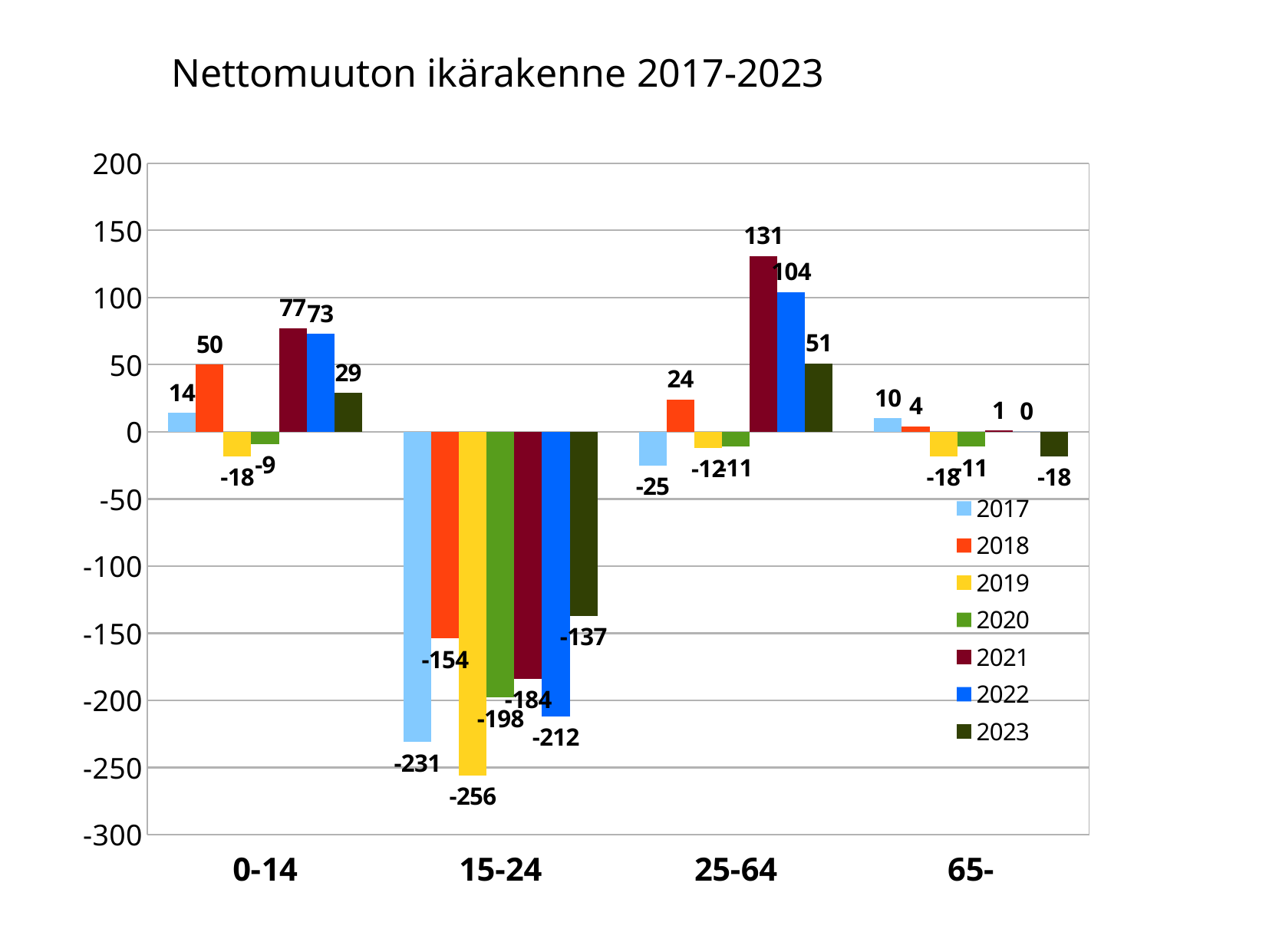
What is the value for 2019 in the 15-24 age group? -256 How many age groups are shown on the x axis? 4 What type of chart is shown on the slide? Bar chart How many series does the legend list? 7 What is the value for 2023 in the 15-24 age group? -137 What is the difference between the 2018 and 2023 values in the 0-14 age group? 21 What is the value for 2021 in the 25-64 age group? 131 Which year has the highest value in the 0-14 age group? 2021 What is the value for 2022 in the 65- age group? 0 In the 15-24 age group, which is higher: the value for 2017 or the value for 2022? 2022 What is the difference between the 2021 and 2022 values in the 25-64 age group? 27 Which age group has the lowest value for 2017? 15-24